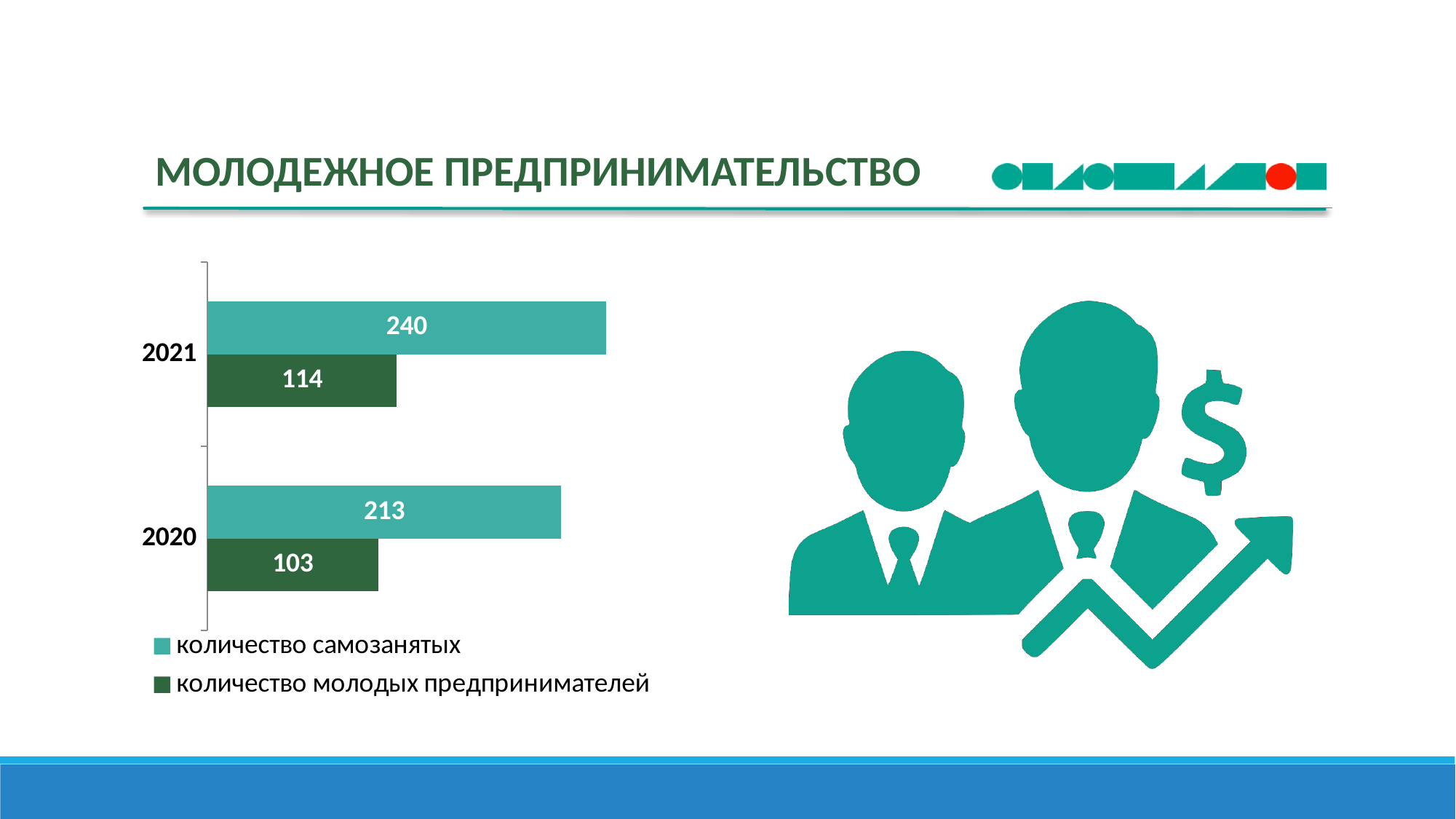
Which year has the higher value for 'количество самозанятых'? 2021 What is the value for 'количество молодых предпринимателей' in 2020? 103 Which is larger in 2020: 'количество самозанятых' or 'количество молодых предпринимателей'? количество самозанятых What is the value for 'количество молодых предпринимателей' in 2021? 114 How many years (categories) are shown on the chart? 2 What kind of chart is shown on the slide? bar chart What is the difference between 'количество самозанятых' in 2021 and in 2020? 27 What is the value for 'количество самозанятых' in 2020? 213 How many series does the legend list? 2 What is the value for 'количество самозанятых' in 2021? 240 Which year has the lower value for 'количество молодых предпринимателей'? 2020 What is the difference between 'количество самозанятых' and 'количество молодых предпринимателей' in 2021? 126